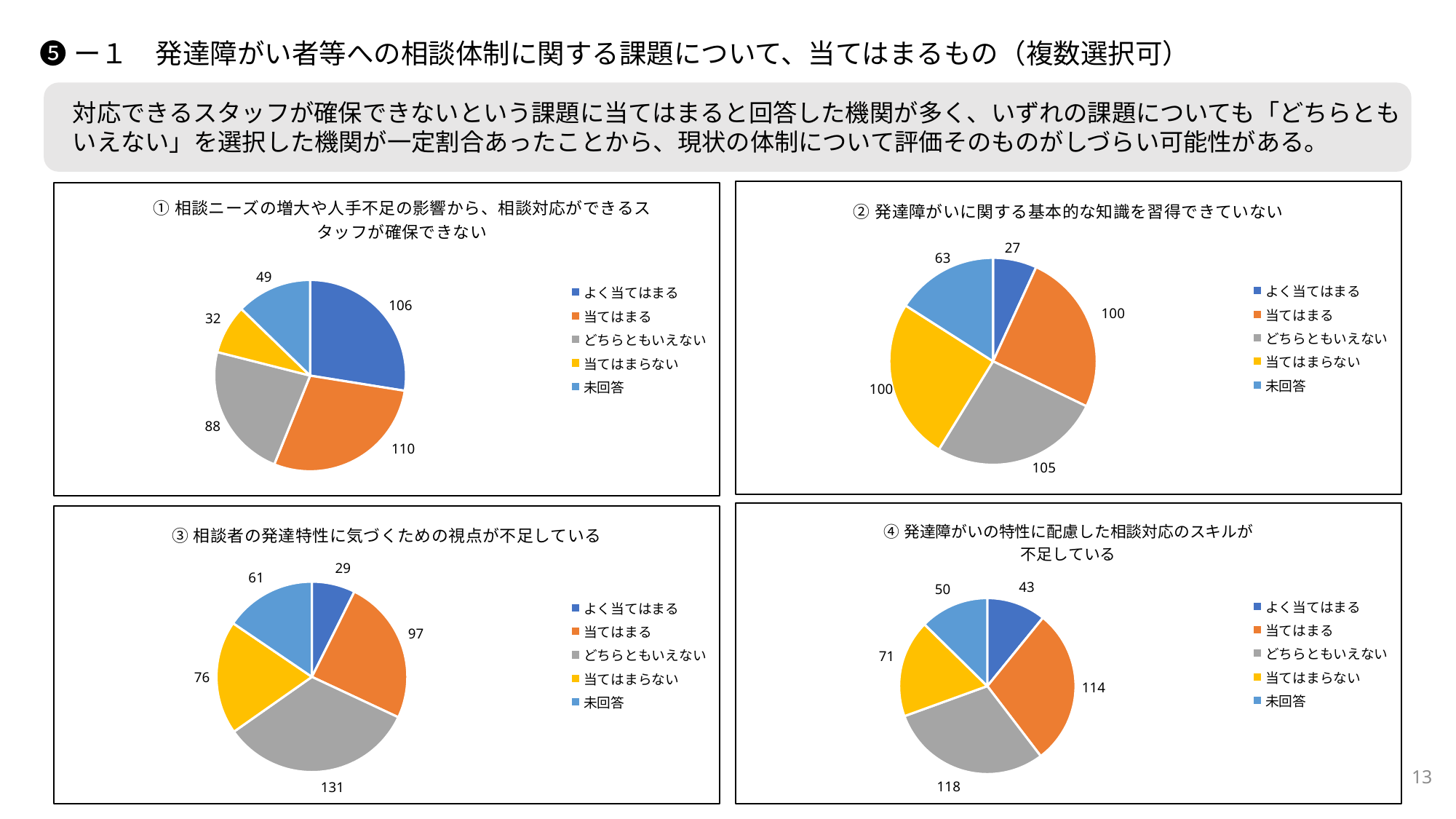
How many slices does the bottom-left chart (③) have? 5 In the top-right chart (②), what is the value for 未回答? 63 In the top-left chart (①), what is the total of all slices? 385 In the bottom-left chart (③), what is the value for 当てはまらない? 76 In the bottom-right chart (④), which category has the highest value? どちらともいえない In the bottom-left chart (③), which category has the lowest value? よく当てはまる In the top-left chart (①), which category has the lowest value? 当てはまらない In the top-left chart (①), what is the value for 当てはまる? 110 In the top-right chart (②), which is larger: どちらともいえない or 未回答? どちらともいえない How many entries does the legend of the top-right chart (②) list? 5 In the bottom-right chart (④), what is the difference between どちらともいえない and 当てはまる? 4 What kind of chart is the top-left chart (①)? Pie chart